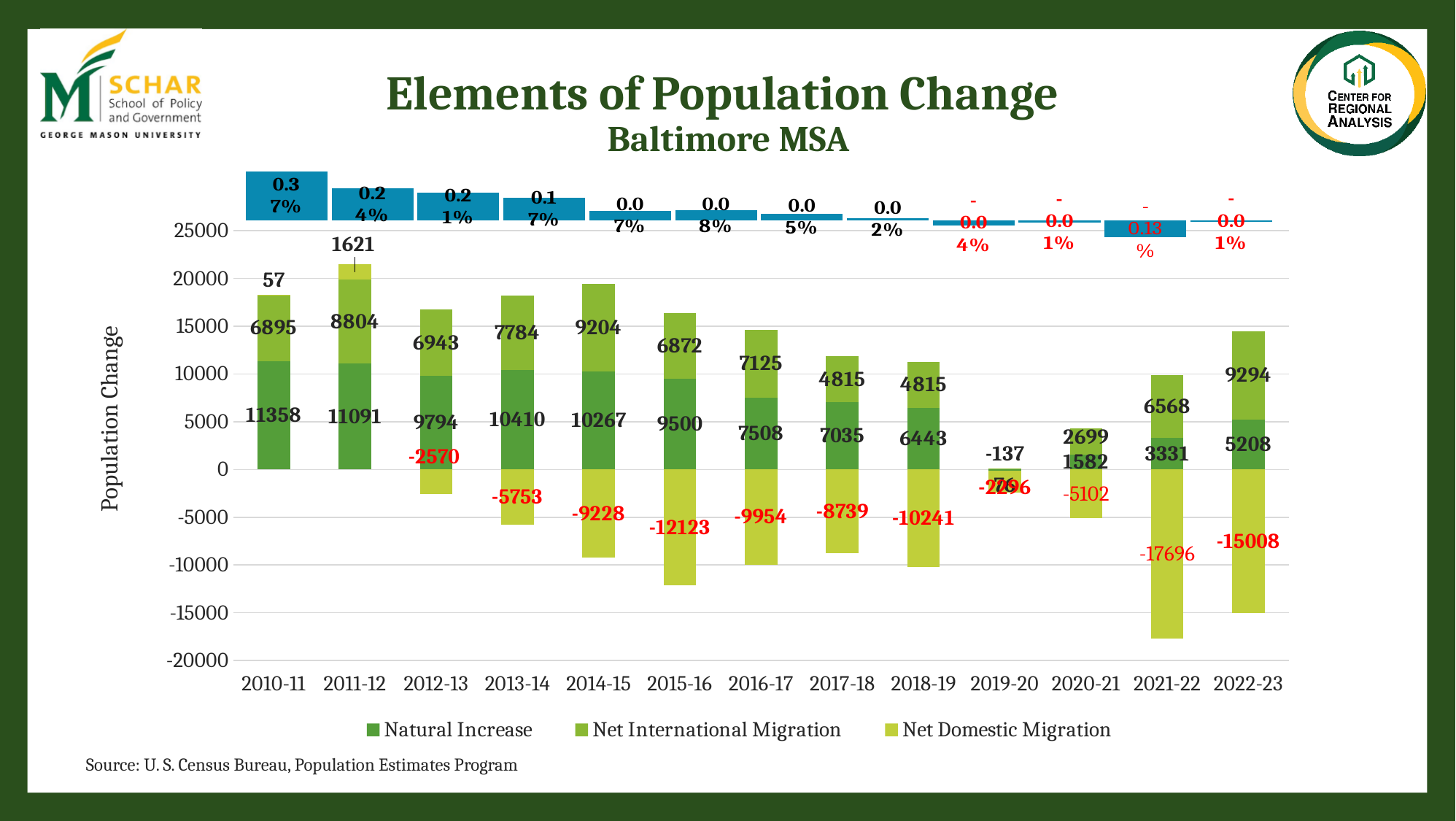
What is the difference between Natural Increase in 2010-11 and in 2022-23? 6150 What is the Natural Increase value for 2010-11? 11358 Does Natural Increase rise or fall from 2010-11 to 2020-21? Fall In which year is Natural Increase highest? 2010-11 How many series does the legend list? 3 Which is larger: Net International Migration in 2014-15 or in 2022-23? 2022-23 How many year categories are shown on the x axis? 13 What is the Net International Migration value for 2017-18? 4815 In which year is Net Domestic Migration lowest? 2021-22 What kind of chart is shown on the slide? Stacked bar chart What is the Net International Migration value for 2022-23? 9294 What is the Net Domestic Migration value for 2021-22? -17696